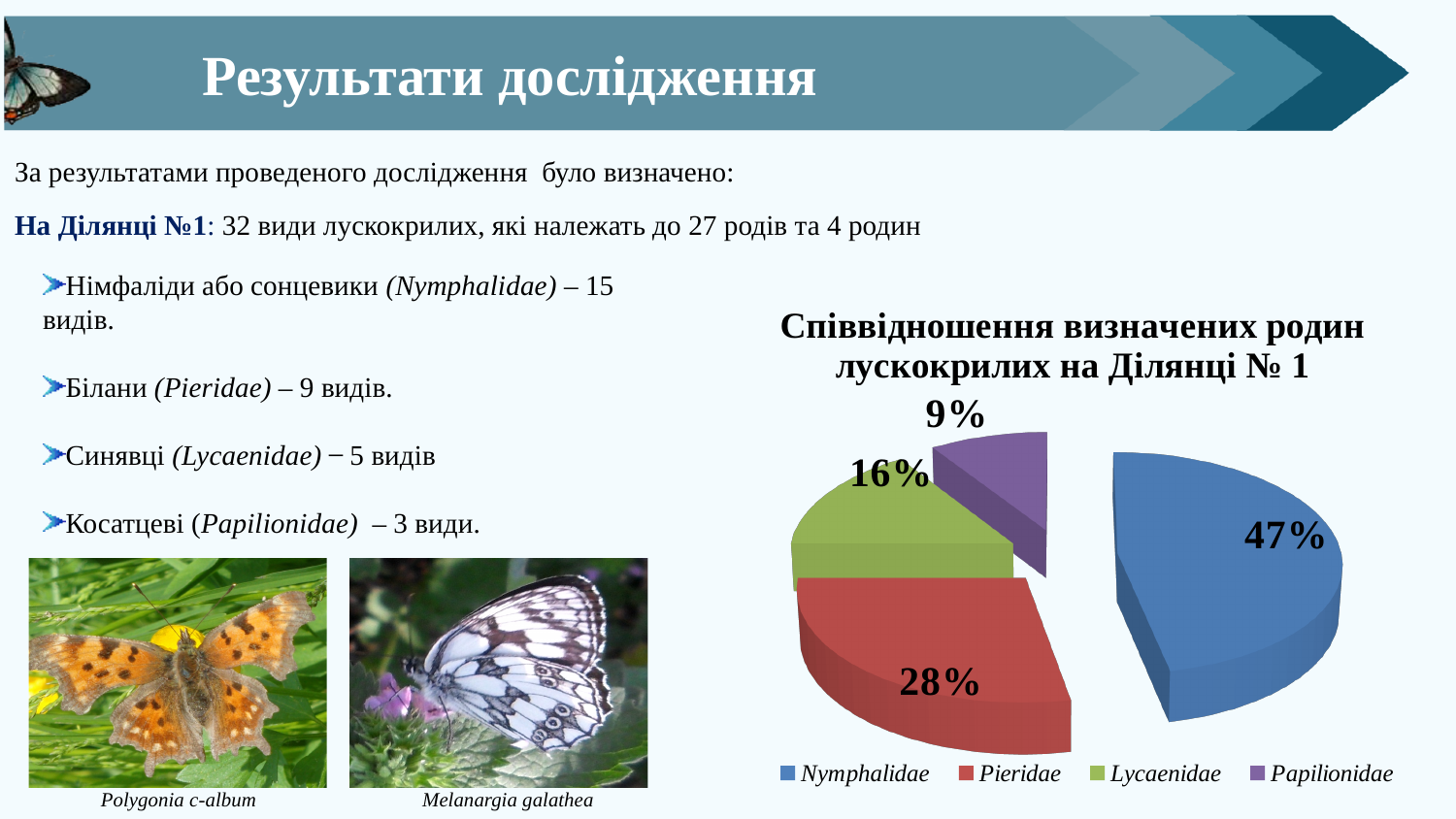
Which slice is larger, Pieridae or Lycaenidae? Pieridae What is the value shown for Pieridae in the pie chart? 28% What percentage of the pie chart does Nymphalidae account for? 47% What colour is the Nymphalidae slice in the pie chart? Blue How many slices does the pie chart have? 4 Which family has the largest slice in the pie chart? Nymphalidae How many entries does the chart legend list? 4 What type of chart is shown on the slide? Pie chart What is the value shown for Lycaenidae in the pie chart? 16% What share of the pie chart does Papilionidae represent? 9% What is the difference in percentage points between the Nymphalidae and Pieridae slices? 19 Which family has the smallest slice in the pie chart? Papilionidae